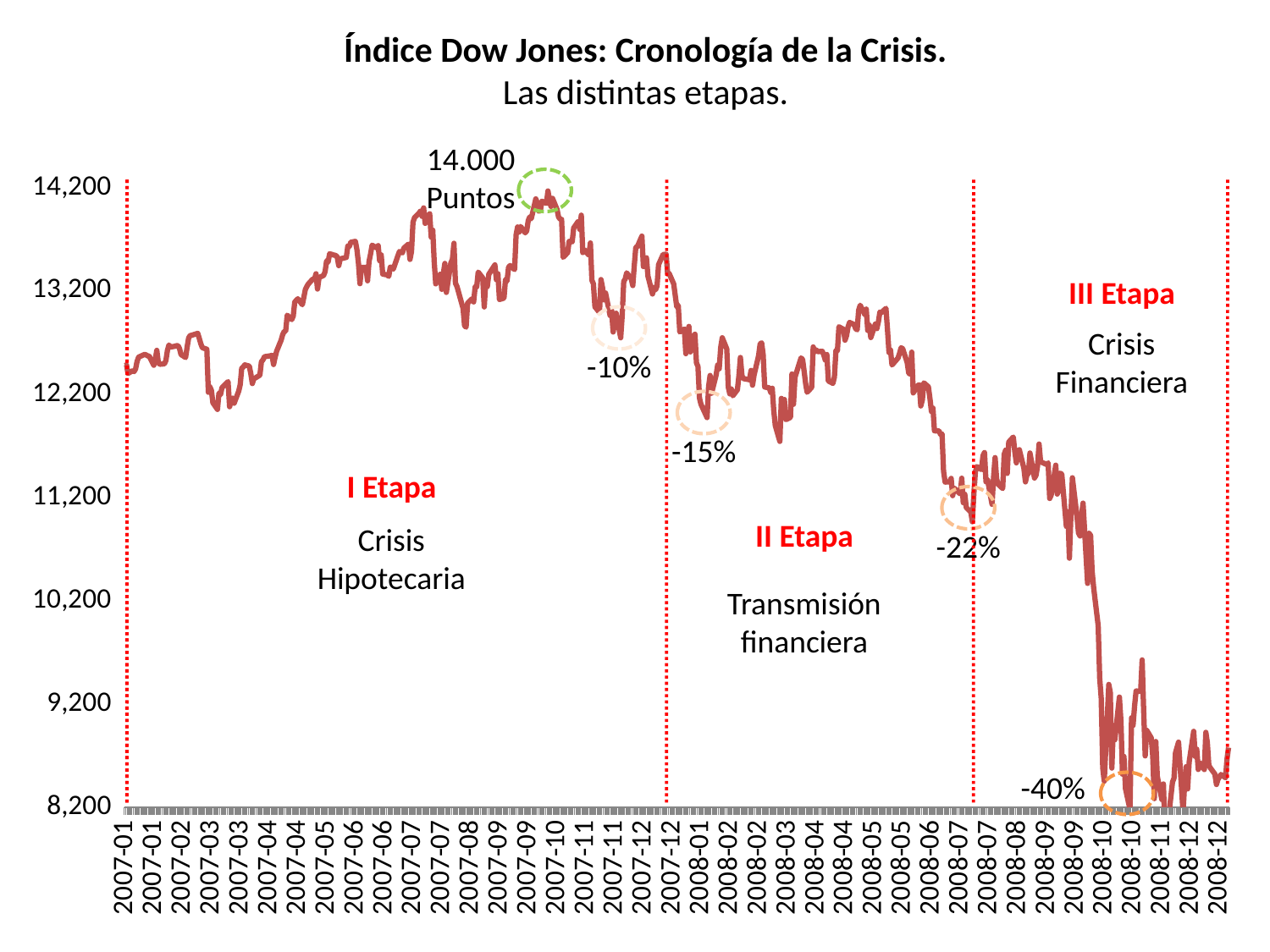
Is the value of the index in 2008-10 greater or less than 10,200? less Is the value of the index in 2008-05 greater or less than 12,200? greater Overall, does the Dow Jones index rise or fall from 2007-01 to 2008-12? fall Around which month does the Dow Jones index reach its highest point on the chart? 2007-10 Is the index value in 2007-10 larger or smaller than the index value in 2008-10? larger What is the title of the chart? Índice Dow Jones: Cronología de la Crisis. Las distintas etapas. What level is annotated at the peak of the index? 14.000 Puntos What kind of chart is shown on the slide? line chart What percentage decline is annotated at the lowest point of the chart, near 2008-10? -40% Is the value of the index in 2007-10 greater or less than 13,200? greater Around which month does the Dow Jones index reach its lowest point on the chart? 2008-11